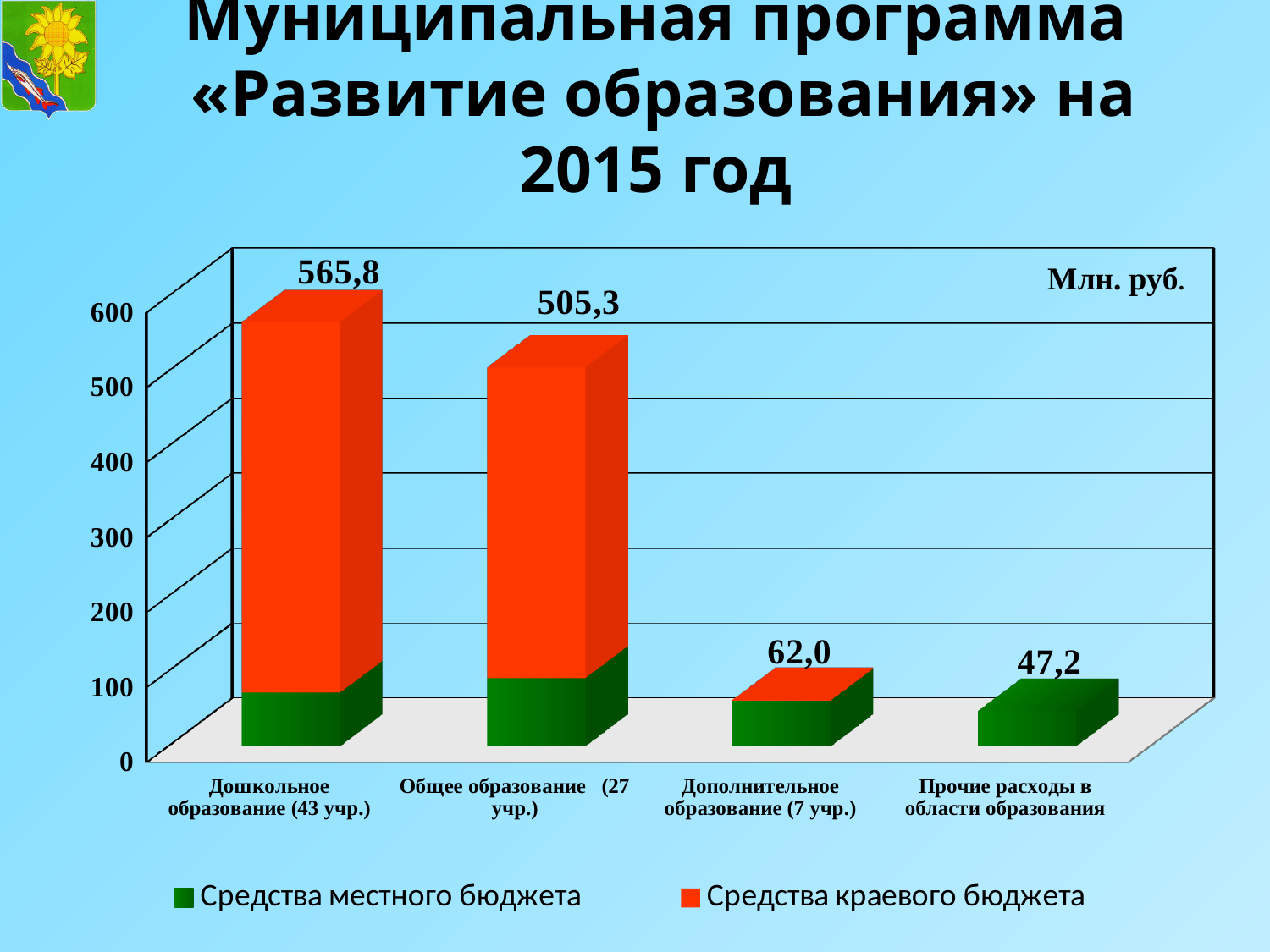
Which category has the lowest total value? Прочие расходы в области образования How many categories are shown on the x axis? 4 What is the total value shown for Прочие расходы в области образования? 47,2 Which category has the highest total value? Дошкольное образование (43 учр.) What is the total value shown for Общее образование (27 учр.)? 505,3 Which has a larger total: Дополнительное образование (7 учр.) or Прочие расходы в области образования? Дополнительное образование (7 учр.) What is the difference between the totals for Дошкольное образование (43 учр.) and Общее образование (27 учр.)? 60,5 What is the total value shown for Дополнительное образование (7 учр.)? 62,0 What is the total value shown for Дошкольное образование (43 учр.)? 565,8 Which series is shown in green in the legend? Средства местного бюджета How many series does the legend list? 2 What kind of chart is shown on the slide? Stacked bar chart